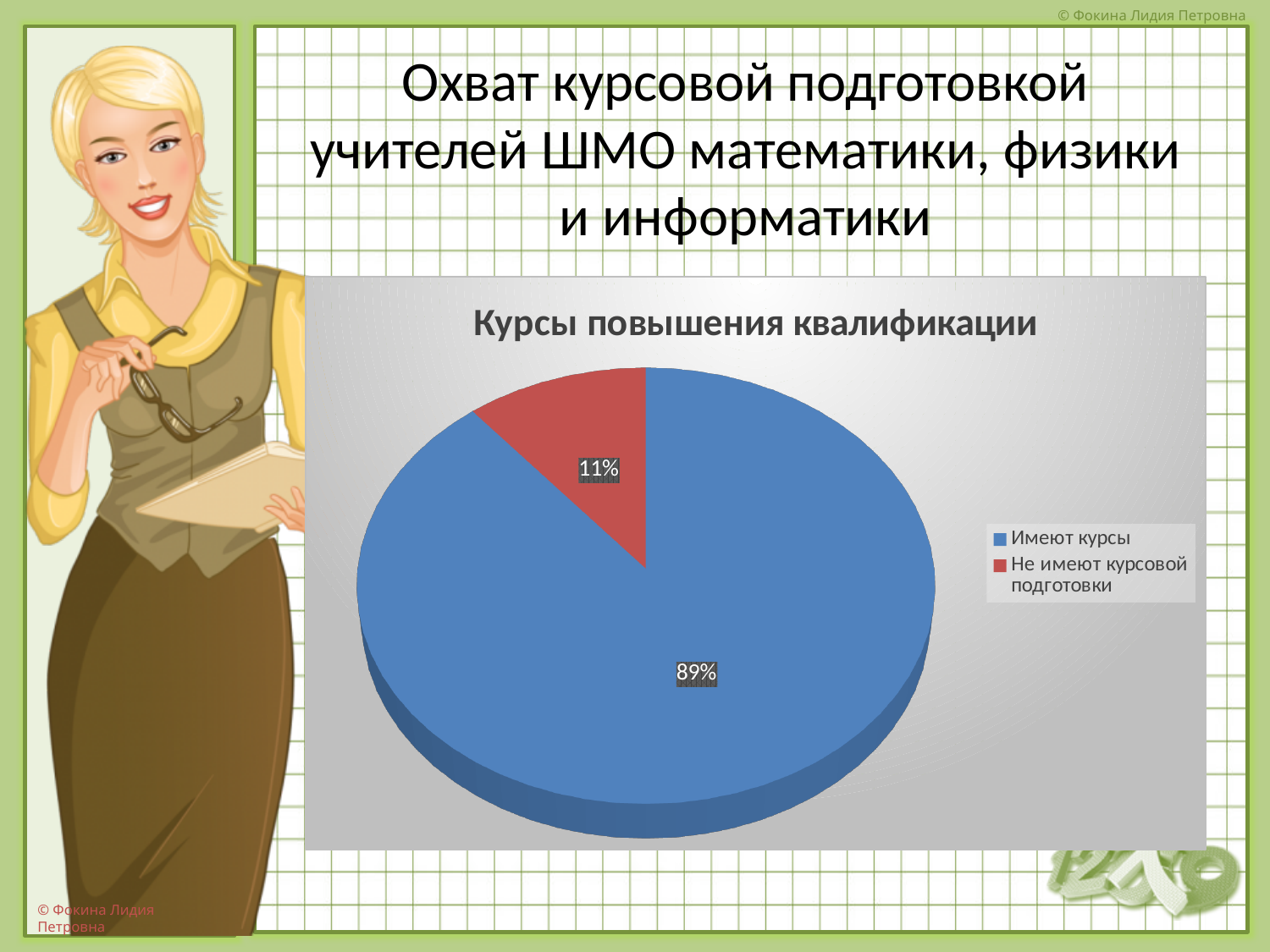
What share of the pie is labelled "Не имеют курсовой подготовки"? 11% What share of the pie is labelled "Имеют курсы"? 89% Which category has the smallest slice of the pie? Не имеют курсовой подготовки What is the difference in percentage points between "Имеют курсы" and "Не имеют курсовой подготовки"? 78 What is the title of the chart? Курсы повышения квалификации Which is larger: the share for "Имеют курсы" or the share for "Не имеют курсовой подготовки"? Имеют курсы What type of chart is shown on the slide? pie chart How many slices does the pie chart have? 2 How many entries does the legend list? 2 Which category has the largest slice of the pie? Имеют курсы What colour is the slice for "Не имеют курсовой подготовки"? red